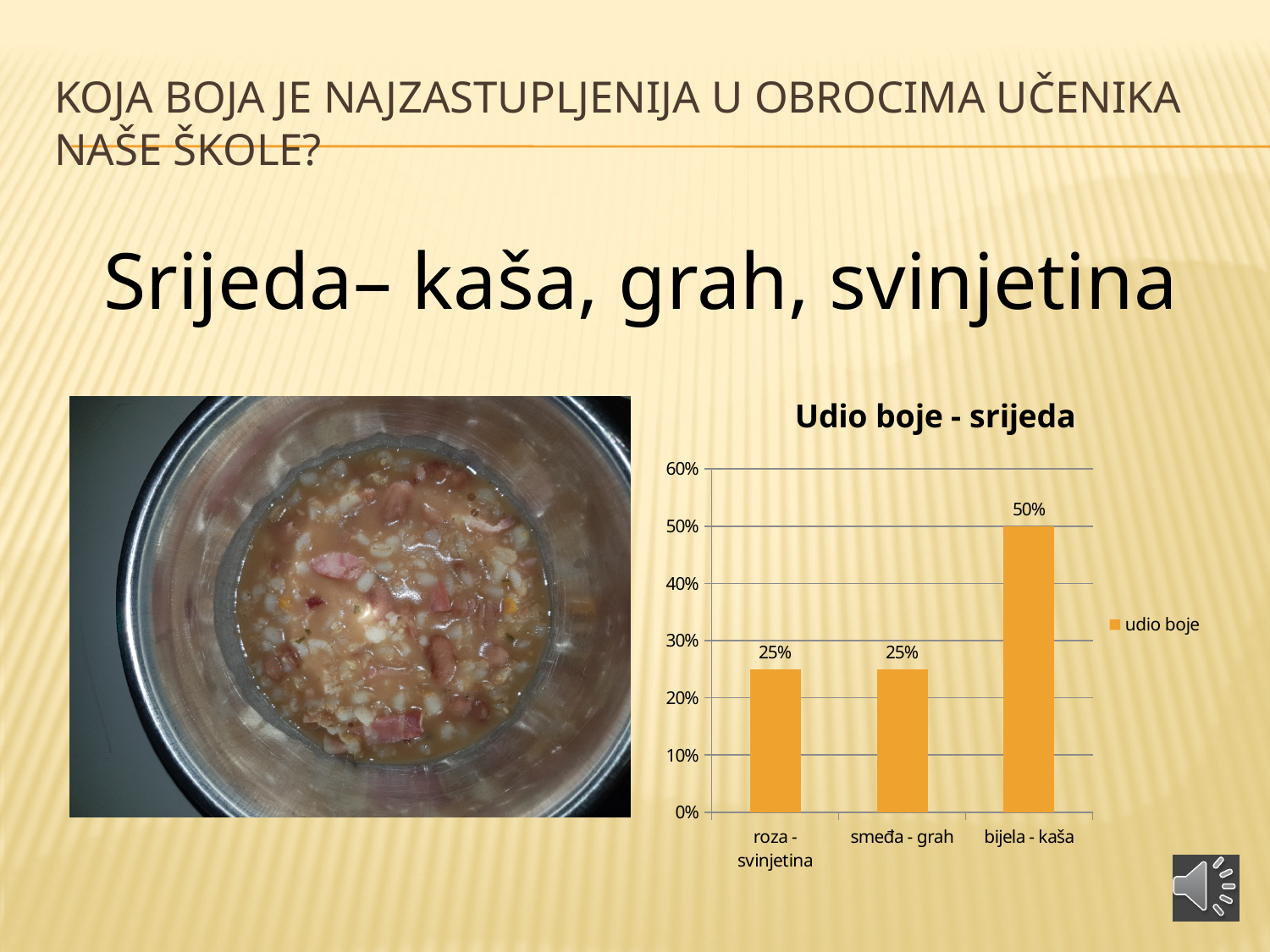
Is the value for bijela - kaša greater or less than 40%? greater What is the title of the chart? Udio boje - srijeda How many categories are shown on the x axis? 3 Is the value for smeđa - grah greater or less than 30%? less What is the value for smeđa - grah? 25% Which is larger, the value for bijela - kaša or the value for roza - svinjetina? bijela - kaša How many series does the legend list? 1 What is the difference between the values for bijela - kaša and smeđa - grah? 25% What is the value for bijela - kaša? 50% Which category has the highest value? bijela - kaša What is the value for roza - svinjetina? 25% What kind of chart is shown? bar chart